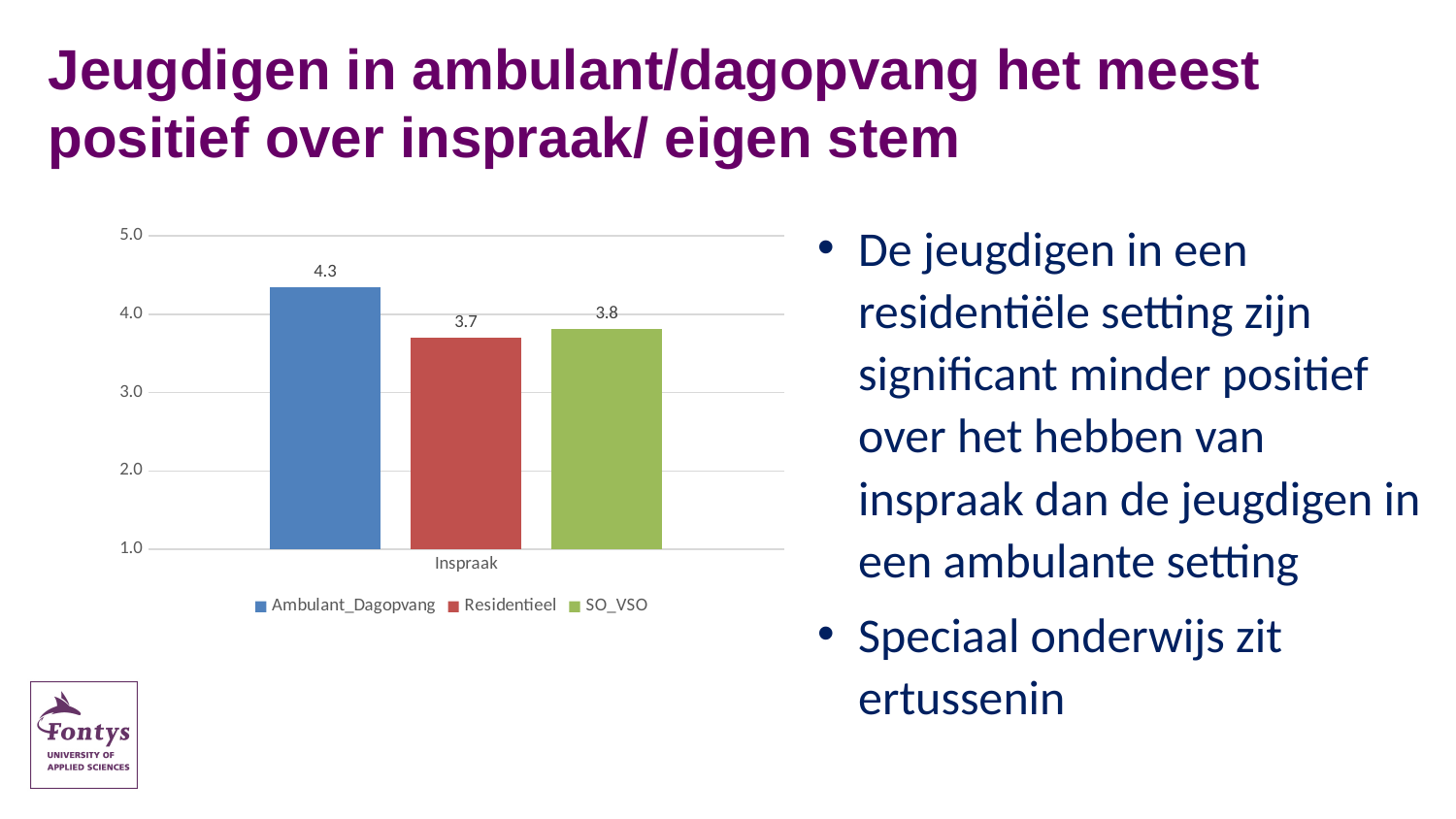
Is the value for Ambulant_Dagopvang greater or less than 4.0? greater What is the difference between the Ambulant_Dagopvang value and the Residentieel value? 0.6 What is the value for Ambulant_Dagopvang on Inspraak? 4.3 What is the value for SO_VSO on Inspraak? 3.8 What is the category label on the x axis of the chart? Inspraak What kind of chart is shown on the slide? bar chart What is the value for Residentieel on Inspraak? 3.7 How many series does the legend list? 3 Is the value for Residentieel greater or less than 4.0? less Which is larger, the value for Ambulant_Dagopvang or the value for SO_VSO? Ambulant_Dagopvang Which series has the highest value for Inspraak? Ambulant_Dagopvang Which series has the lowest value for Inspraak? Residentieel